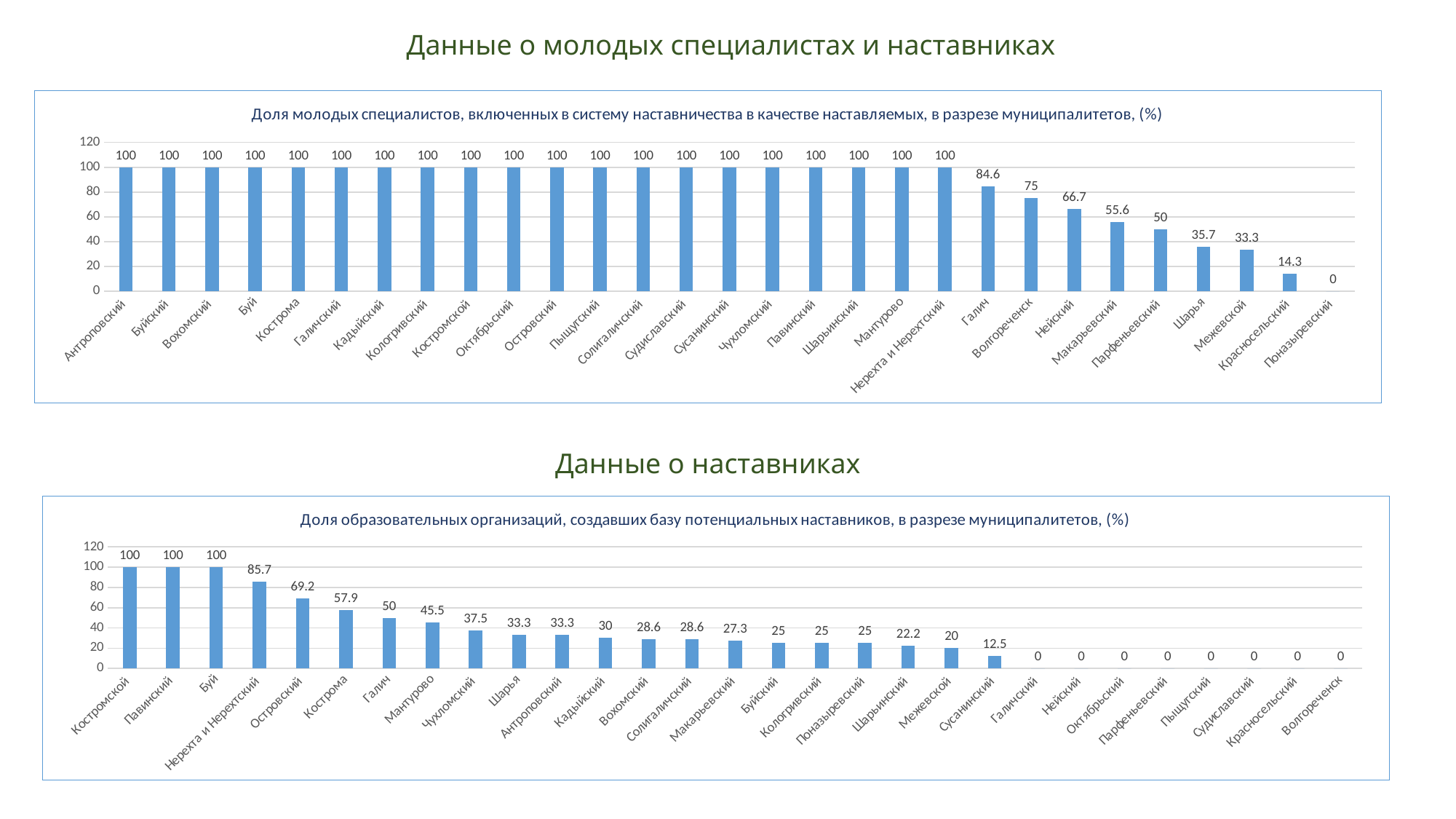
In the bottom chart (Доля образовательных организаций...), what is the value for Сусанинский? 12.5 In the bottom chart (Доля образовательных организаций...), which is larger: the value for Мантурово or the value for Чухломский? Мантурово In the bottom chart (Доля образовательных организаций...), what is the difference between the values for Островский and Кострома? 11.3 In the bottom chart (Доля образовательных организаций...), do the values rise or fall from left to right along the x axis? fall In the top chart (Доля молодых специалистов...), which municipality has the lowest value? Поназыревский In the bottom chart (Доля образовательных организаций...), what is the value for Нерехта и Нерехтский? 85.7 How many municipalities are shown in the bottom chart (Доля образовательных организаций...)? 29 What type of chart is the bottom chart (Доля образовательных организаций...)? bar chart In the top chart (Доля молодых специалистов...), which is larger: the value for Нейский or the value for Макарьевский? Нейский In the top chart (Доля молодых специалистов...), what is the value for Красносельский? 14.3 In the top chart (Доля молодых специалистов...), what is the value for Галич? 84.6 In the top chart (Доля молодых специалистов...), what is the difference between the values for Волгореченск and Парфеньевский? 25